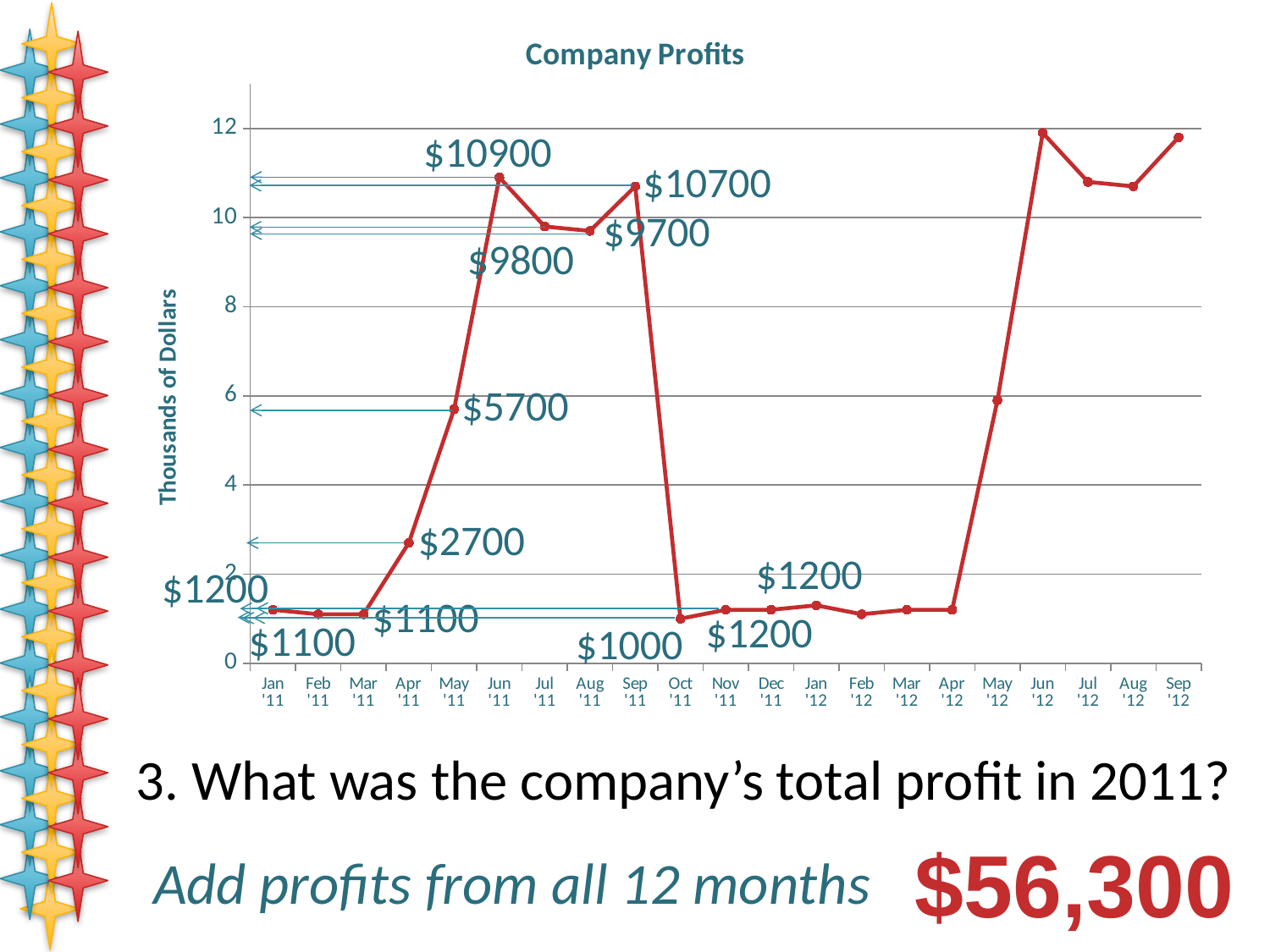
What was the company's profit in Jun '11? $10900 What is the difference between the profit in Jun '11 and the profit in Sep '11? $200 Which month in 2011 had the lowest profit? Oct '11 Is the value for Jun '12 greater or less than 10 thousand dollars? greater What was the company's total profit in 2011? $56,300 What was the company's profit in May '11? $5700 How many months are plotted on the x axis of the chart? 21 What kind of chart is shown on the slide? Line chart Is the value for May '12 greater or less than 8 thousand dollars? less Which month had the larger profit, Jul '11 or Aug '11? Jul '11 What was the company's profit in Oct '11? $1000 Which month in 2011 had the highest profit? Jun '11